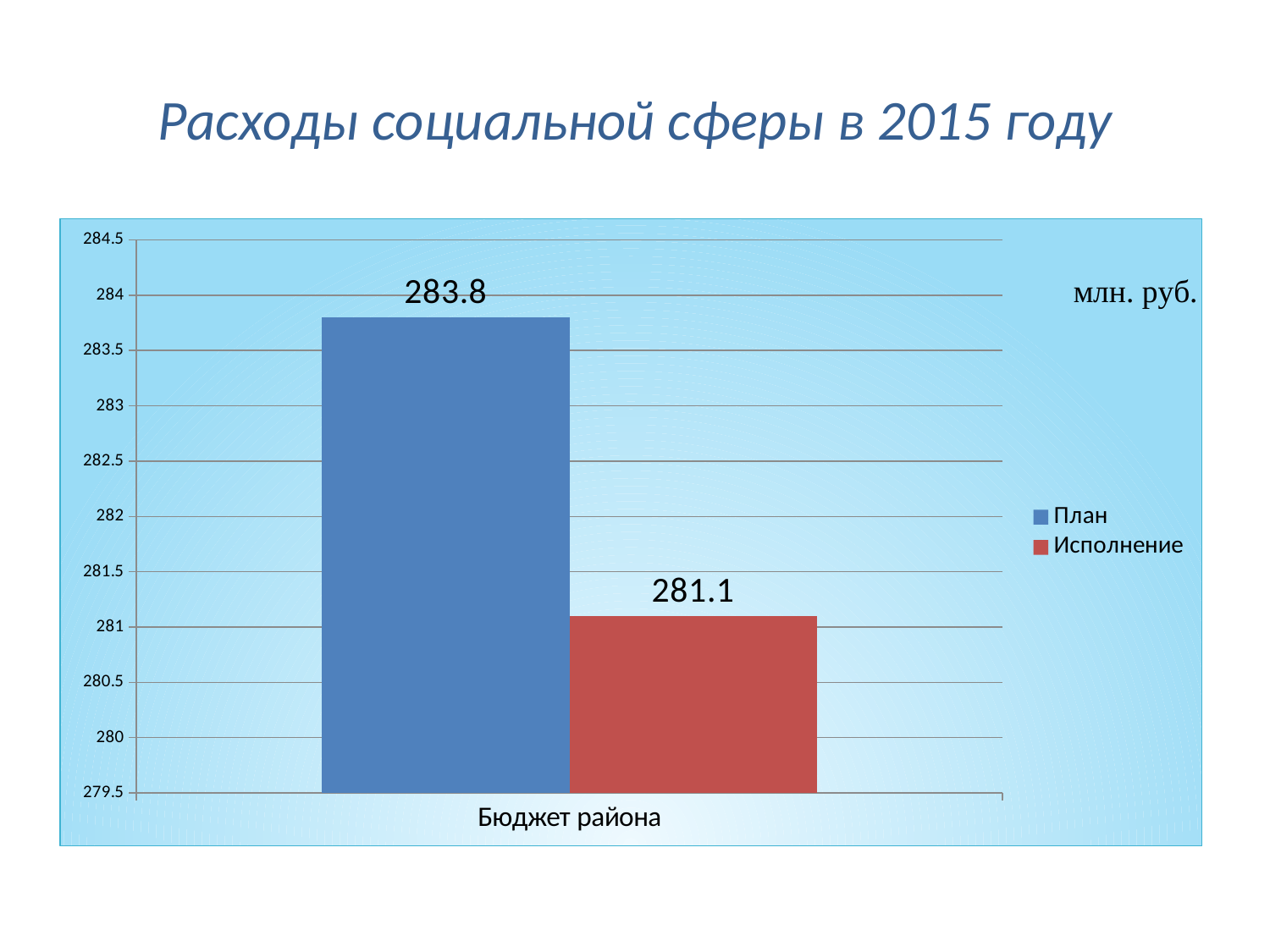
How many categories are shown on the x axis? 1 What is the value of План for Бюджет района? 283.8 What unit is indicated next to the chart? млн. руб. What is the difference between the План and Исполнение values? 2.7 Is the value for Исполнение greater or less than 282? less What is the title of the slide? Расходы социальной сферы в 2015 году Which series has the higher value, План or Исполнение? План Is the value for План greater or less than 283? greater How many series does the legend list? 2 What kind of chart is shown on the slide? bar chart Which series has the lowest value on the chart? Исполнение What is the value of Исполнение for Бюджет района? 281.1